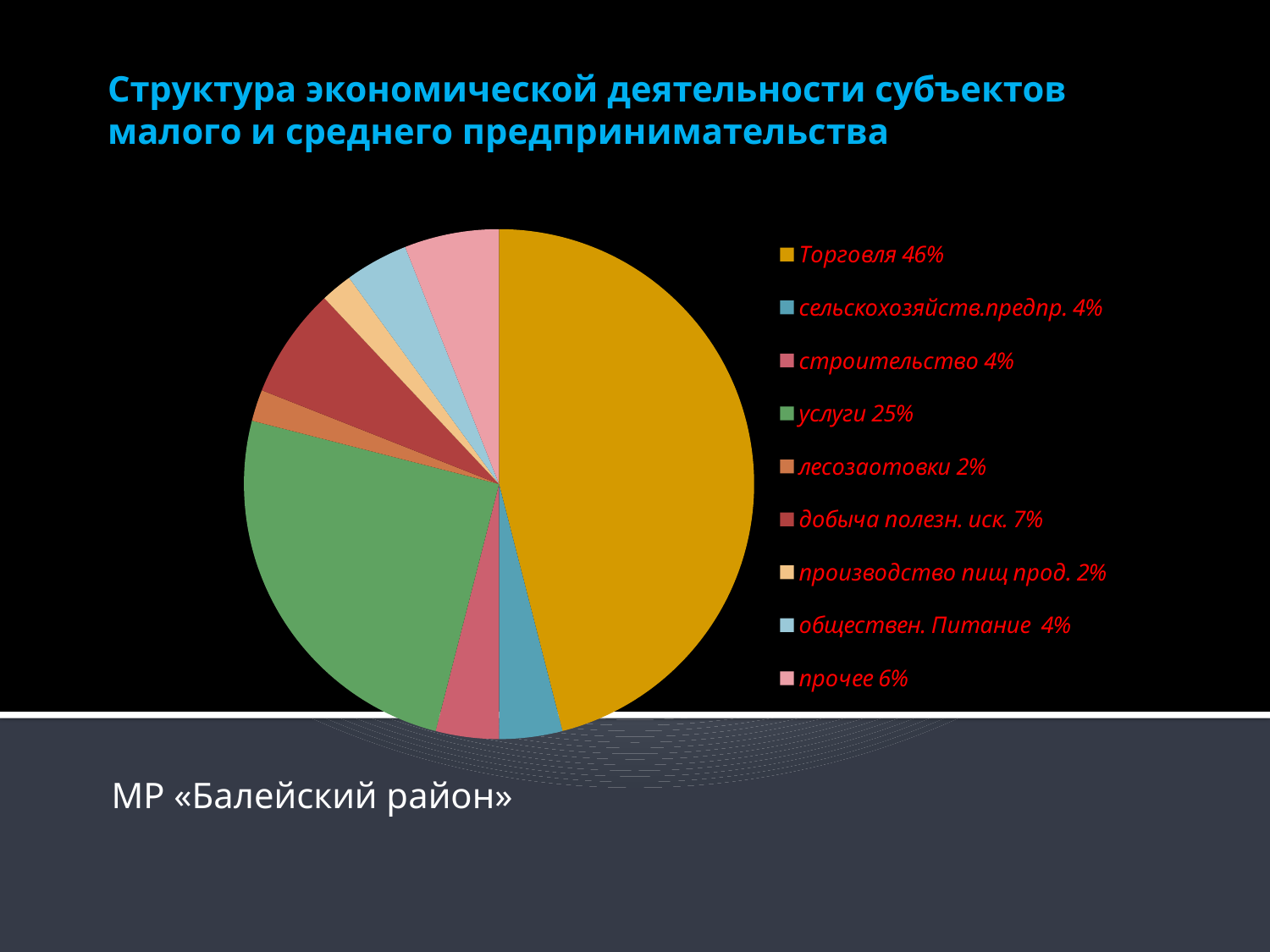
What share of the pie does Торговля account for? 46% What percentage is shown for лесозаотовки? 2% What percentage is shown for прочее? 6% What percentage is shown for добыча полезн. иск.? 7% What is the title of the slide above the chart? Структура экономической деятельности субъектов малого и среднего предпринимательства What percentage is shown for услуги in the legend? 25% Which category has the largest slice of the pie? Торговля How many categories does the pie chart have? 9 Which is larger, услуги or добыча полезн. иск.? услуги What colour is the slice for Торговля? Gold (yellow-orange) What is the difference in percentage points between Торговля and услуги? 21% What kind of chart is shown on the slide? Pie chart